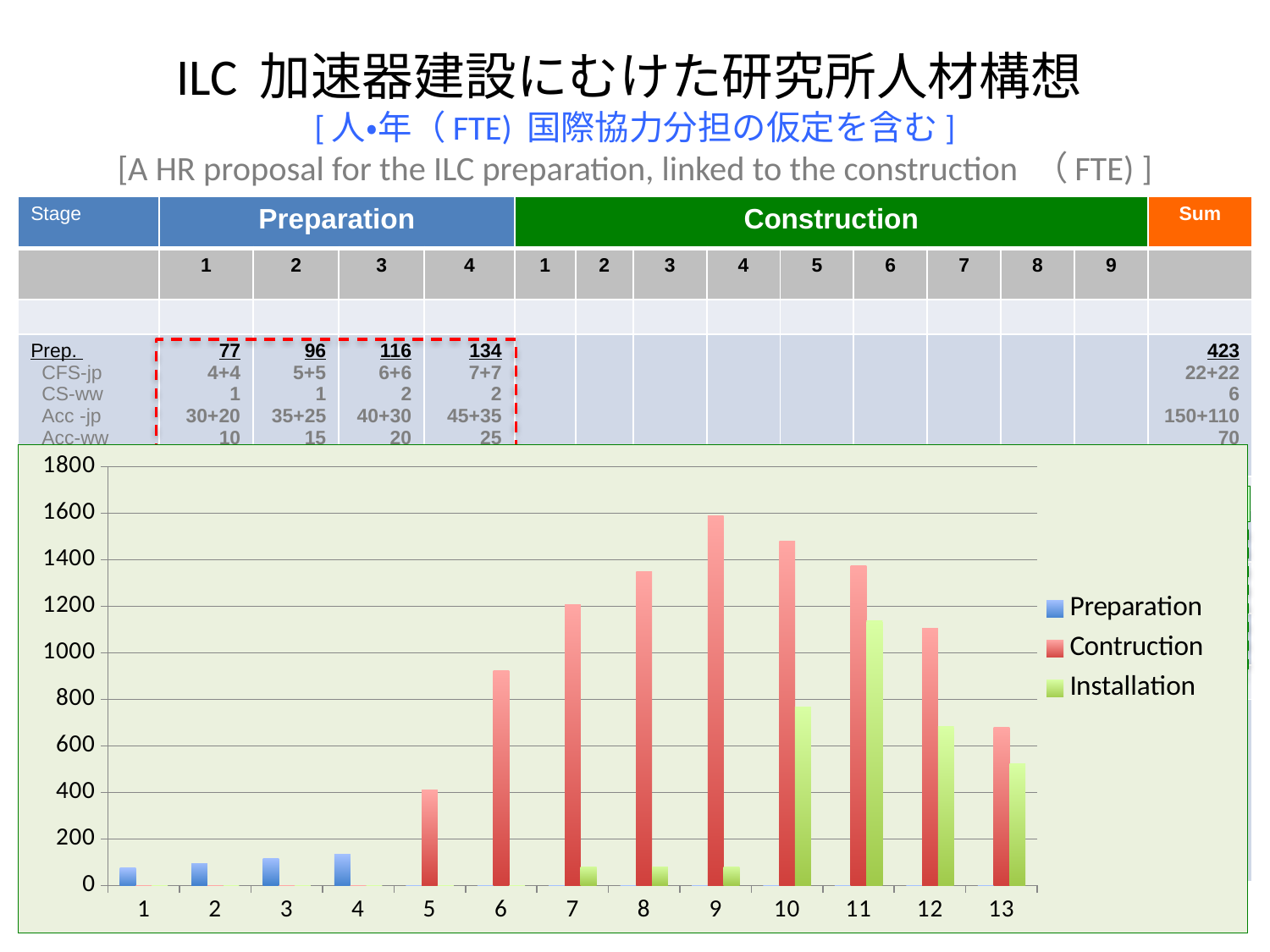
At category 10, which is larger: the Contruction value or the Installation value? Contruction Is the Contruction value at category 5 greater or less than 600? less Is the Contruction value at category 9 greater or less than 1400? greater Is the Installation value at category 11 greater or less than 1000? greater At which x-axis category is the Installation series highest? 11 At which x-axis category is the Contruction series highest? 9 What kind of chart is shown on the slide? bar chart How many series does the chart legend list? 3 How many categories are shown along the x axis of the chart? 13 Does the Contruction series rise or fall from category 9 to category 13? fall What are the three entries listed in the chart legend? Preparation, Contruction, Installation